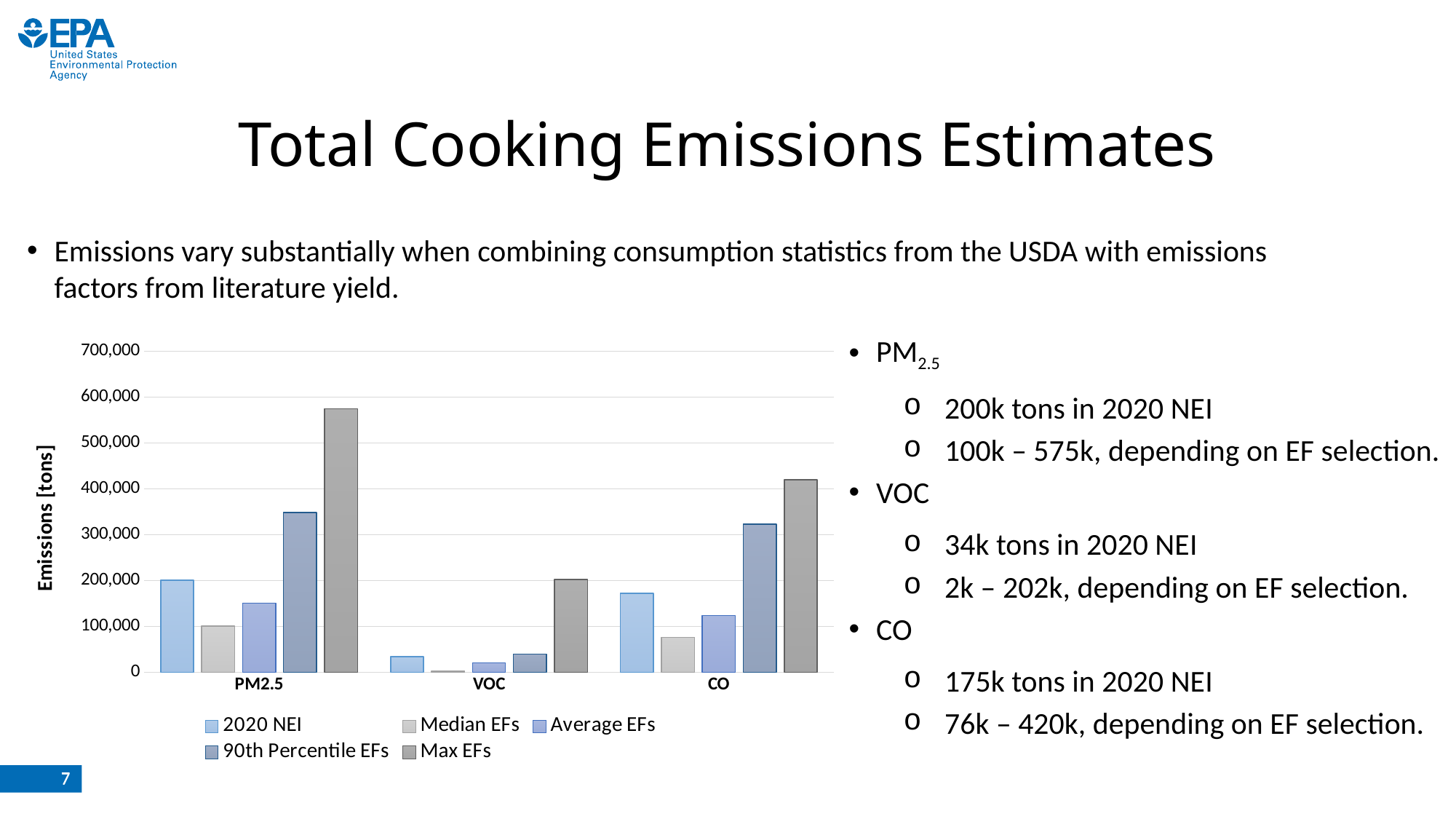
Which category has the tallest Max EFs bar? PM2.5 Which is larger, the 2020 NEI value for PM2.5 or the 2020 NEI value for CO? PM2.5 Which is larger, the Max EFs value for PM2.5 or the Max EFs value for CO? PM2.5 Is the 2020 NEI value for VOC greater or less than 100,000? less Which series has the lowest bar in the VOC group? Median EFs What is the label of the chart's y axis? Emissions [tons] Which series has the highest bar in the PM2.5 group? Max EFs Is the 90th Percentile EFs value for CO greater or less than 300,000? greater What kind of chart is shown on the slide? bar chart How many series does the chart legend list? 5 How many pollutant categories are shown on the x axis of the chart? 3 Is the Max EFs value for PM2.5 greater or less than 500,000? greater